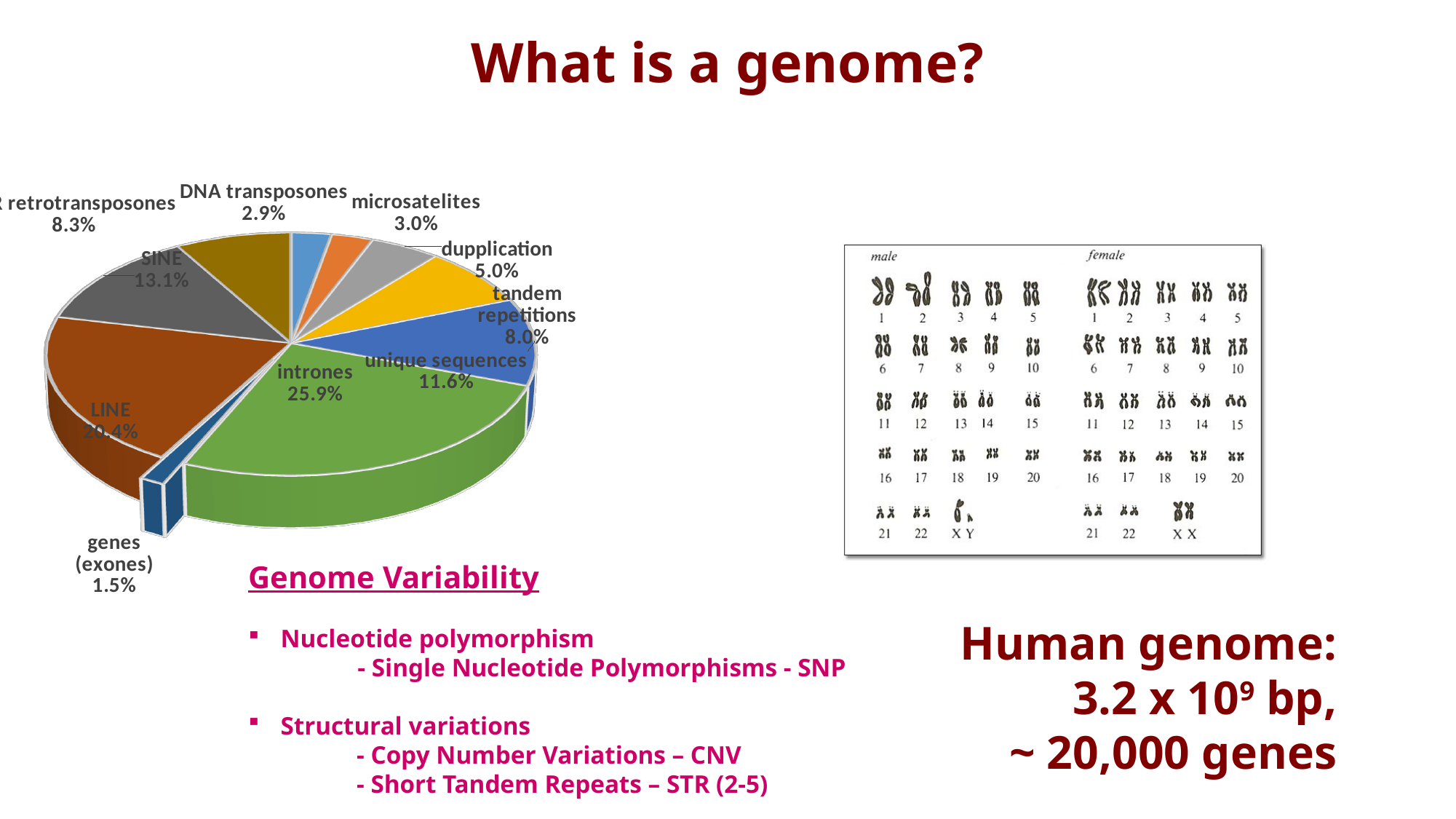
In the pie chart, what percentage is shown for genes (exones)? 1.5% In the pie chart, what is the difference between the dupplication share and the microsatelites share? 2.0% In the pie chart, what percentage is shown for intrones? 25.9% In the pie chart, what percentage is shown for tandem repetitions? 8.0% Which slice of the pie chart is the largest? intrones In the pie chart, which is larger: SINE or LINE? LINE How many slices does the pie chart have? 10 What kind of chart is shown on the left of the slide? pie chart In the pie chart, what is the difference between the intrones share and the LINE share? 5.5% In the pie chart, what percentage is shown for unique sequences? 11.6% Which slice of the pie chart is the smallest? genes (exones) In the pie chart, what percentage is shown for LINE? 20.4%